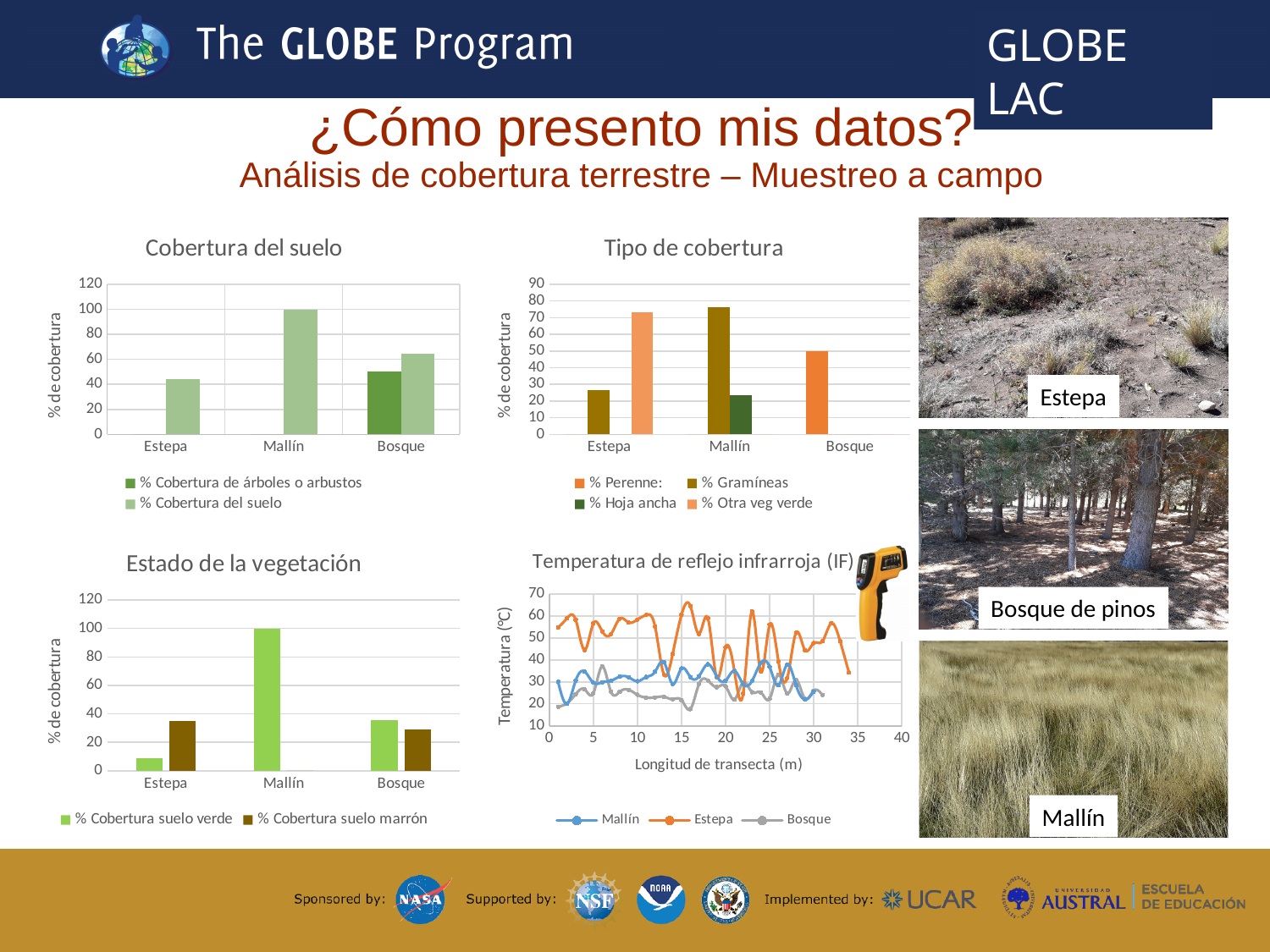
In the 'Tipo de cobertura' chart, is the value of % Gramíneas for Mallín greater or less than 60? greater In the 'Estado de la vegetación' chart, for Estepa, which is larger: % Cobertura suelo verde or % Cobertura suelo marrón? % Cobertura suelo marrón In the 'Tipo de cobertura' chart, for Estepa, which is larger: % Gramíneas or % Otra veg verde? % Otra veg verde In the 'Temperatura de reflejo infrarroja (IF)' chart, what is the title of the x axis? Longitud de transecta (m) In the 'Estado de la vegetación' chart, which category has the highest value for % Cobertura suelo verde? Mallín In the 'Temperatura de reflejo infrarroja (IF)' chart, how many series does the legend list? 3 In the 'Cobertura del suelo' chart, which category has the highest value for % Cobertura del suelo? Mallín What kind of chart is 'Cobertura del suelo'? bar chart In the 'Cobertura del suelo' chart, is the value of % Cobertura del suelo for Estepa greater or less than 60? less What kind of chart is 'Temperatura de reflejo infrarroja (IF)'? line chart In the 'Tipo de cobertura' chart, how many series does the legend list? 4 In the 'Estado de la vegetación' chart, how many categories are shown on the x axis? 3